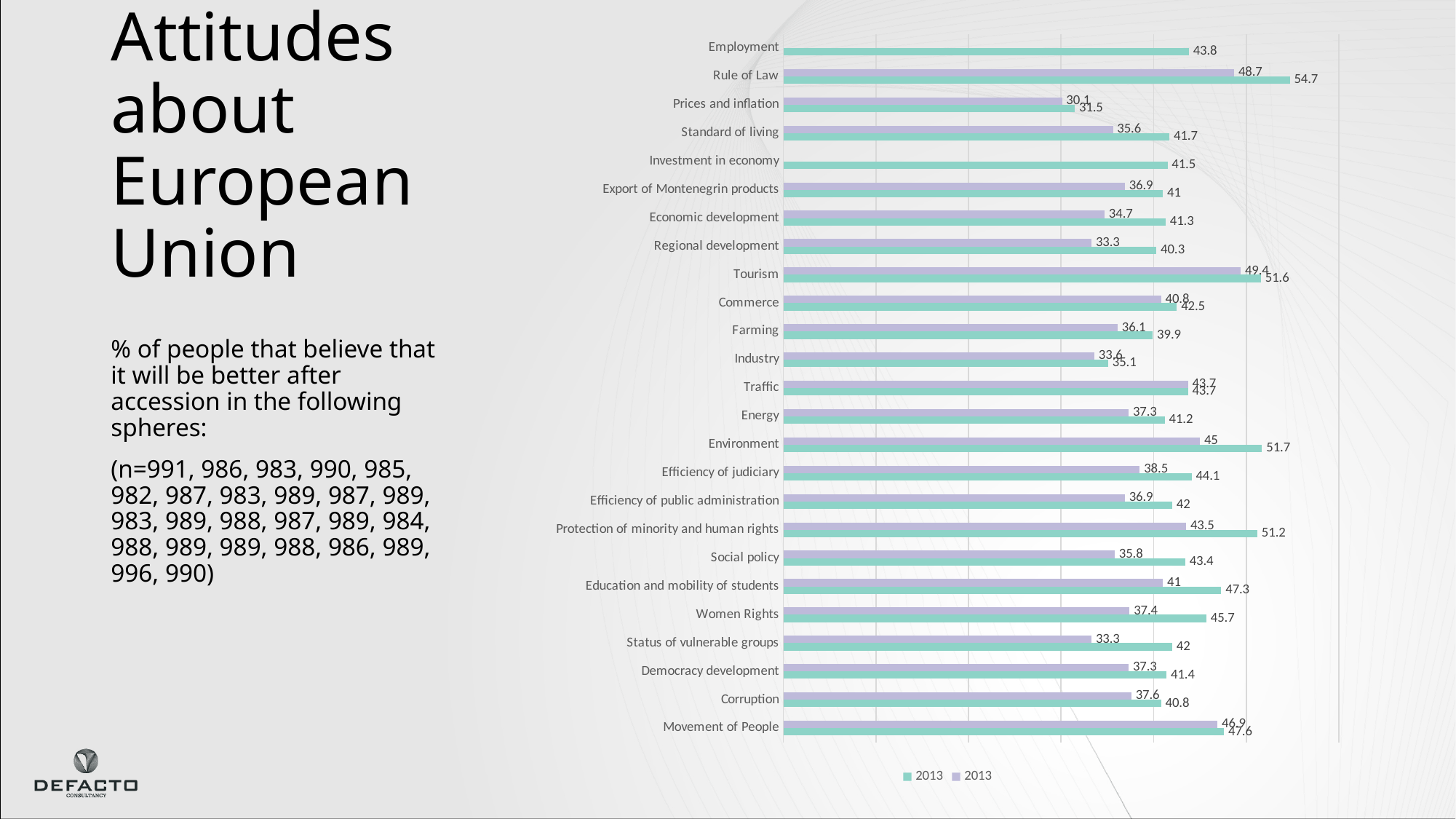
What type of chart is shown on the slide? bar chart How many series does the chart legend list? 2 How many categories (spheres) are listed on the chart? 25 What is the value of the green bar for Employment? 43.8 Which category has the highest green bar value? Rule of Law Which is larger, the green bar for Rule of Law or the green bar for Tourism? Rule of Law What is the value of the green bar for Rule of Law? 54.7 What is the difference between the green and purple bar values for Environment? 6.7 What is the value of the purple bar for Tourism? 49.4 What is the difference between the green and purple bar values for Rule of Law? 6 Which category has the lowest purple bar value? Prices and inflation What is the value of the purple bar for Protection of minority and human rights? 43.5